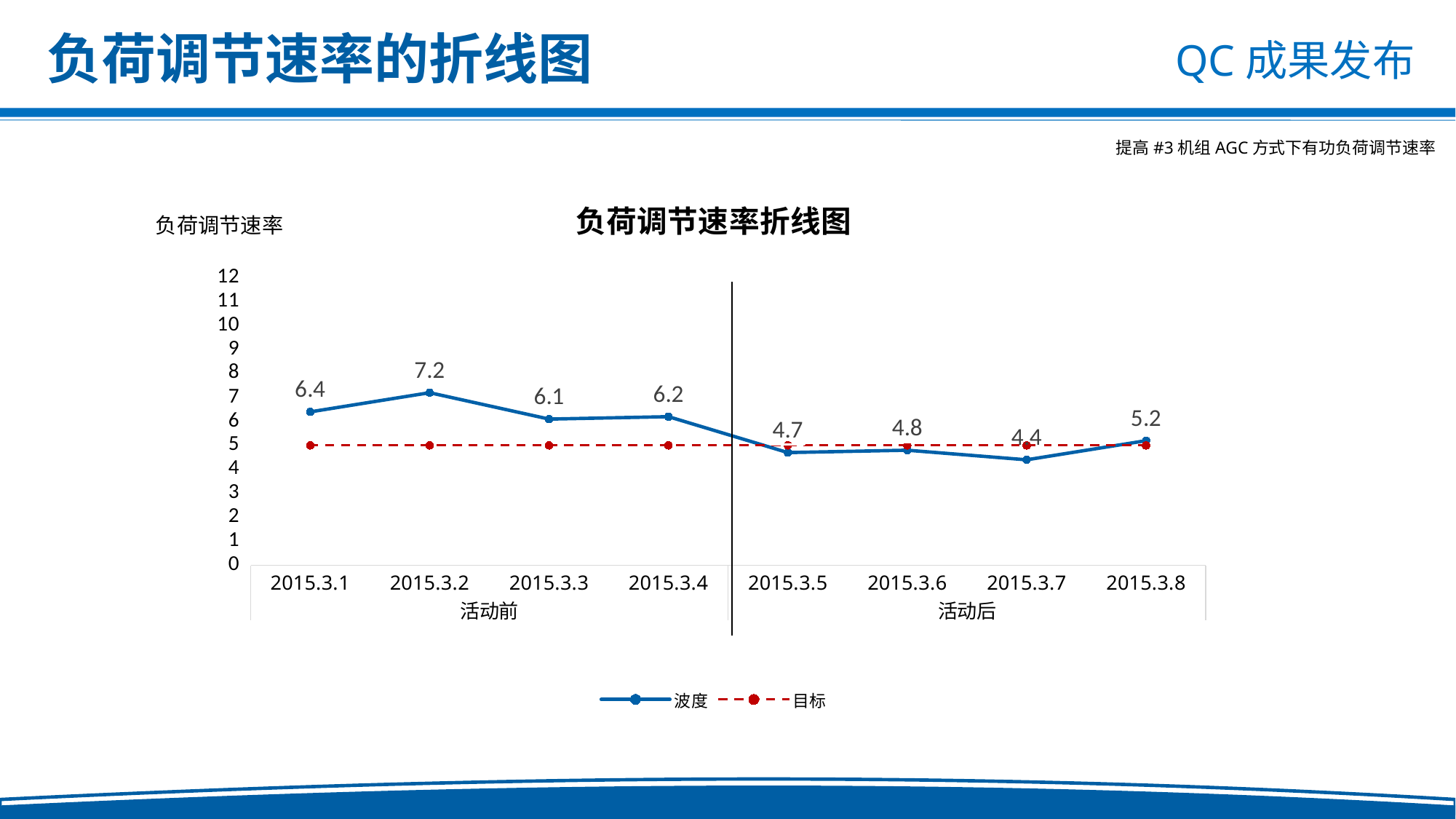
What is the 波度 value for 2015.3.8? 5.2 Which date has the lowest 波度 value? 2015.3.7 Is the 波度 value for 2015.3.3 greater or less than 5? greater What kind of chart is this? line chart How many dates are shown on the x axis? 8 What is the difference between the 波度 values for 2015.3.2 and 2015.3.1? 0.8 What is the 波度 value for 2015.3.2? 7.2 Which date has the highest 波度 value? 2015.3.2 How many series does the legend list? 2 What is the 波度 value for 2015.3.7? 4.4 Does the 波度 value rise or fall from 2015.3.2 to 2015.3.3? fall Which has the larger 波度 value, 2015.3.4 or 2015.3.5? 2015.3.4